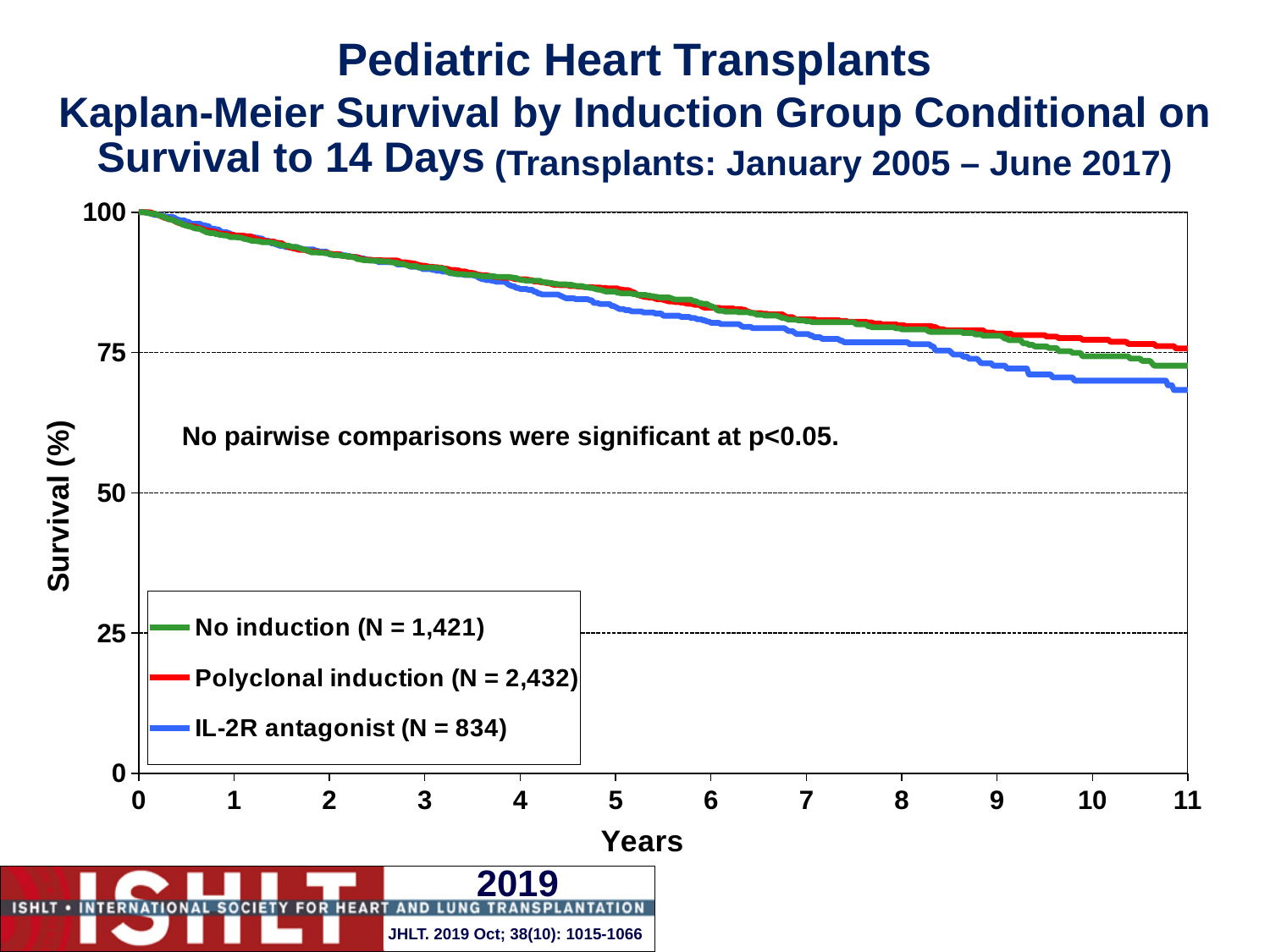
What is the N for the IL-2R antagonist group shown in the legend? 834 What is the N for the Polyclonal induction group shown in the legend? 2,432 Which colour represents the Polyclonal induction group? Red What is the N for the No induction group shown in the legend? 1,421 At 5 years, is the survival for the No induction group greater or less than 75? greater At 11 years, is the survival for the IL-2R antagonist group greater or less than 75? less What kind of chart is shown on the slide? Line chart Do the survival curves rise or fall as years increase? Fall At 11 years, which is higher: survival for Polyclonal induction or for IL-2R antagonist? Polyclonal induction How many series does the legend list? 3 At 11 years, which group has the lowest survival? IL-2R antagonist What is the label of the y axis? Survival (%)